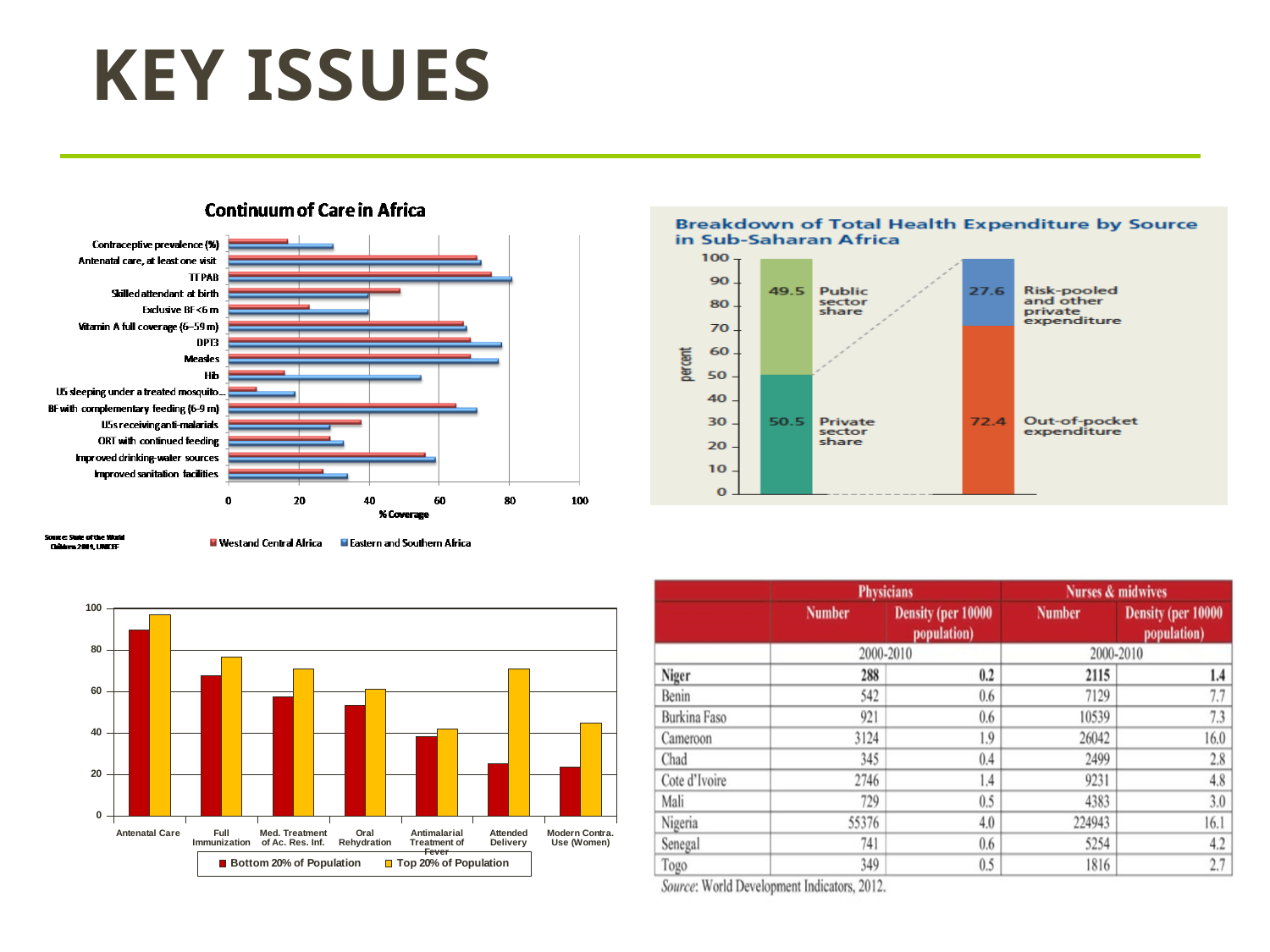
On the 'Continuum of Care in Africa' chart, what kind of chart is shown? Bar chart On the 'Continuum of Care in Africa' chart, is the value for Hib in West and Central Africa greater or less than 20? less On the 'Continuum of Care in Africa' chart, which category has the lowest value for West and Central Africa? U5 sleeping under a treated mosquito... On the bottom-left chart comparing Bottom 20% and Top 20% of Population, how many categories are plotted? 7 On the 'Breakdown of Total Health Expenditure by Source in Sub-Saharan Africa' chart, what is the public sector share? 49.5 On the 'Continuum of Care in Africa' chart, which region has the larger value for Hib? Eastern and Southern Africa On the bottom-left chart comparing Bottom 20% and Top 20% of Population, which category has the highest value for the Top 20% of Population? Antenatal Care On the 'Continuum of Care in Africa' chart, how many categories are plotted? 15 On the bottom-left chart comparing Bottom 20% and Top 20% of Population, is the value for Antenatal Care for the Bottom 20% of Population greater or less than 80? greater On the 'Continuum of Care in Africa' chart, how many series does the legend list? 2 On the 'Breakdown of Total Health Expenditure by Source in Sub-Saharan Africa' chart, what is the out-of-pocket expenditure value? 72.4 On the 'Breakdown of Total Health Expenditure by Source in Sub-Saharan Africa' chart, what is the difference between out-of-pocket expenditure and risk-pooled and other private expenditure? 44.8